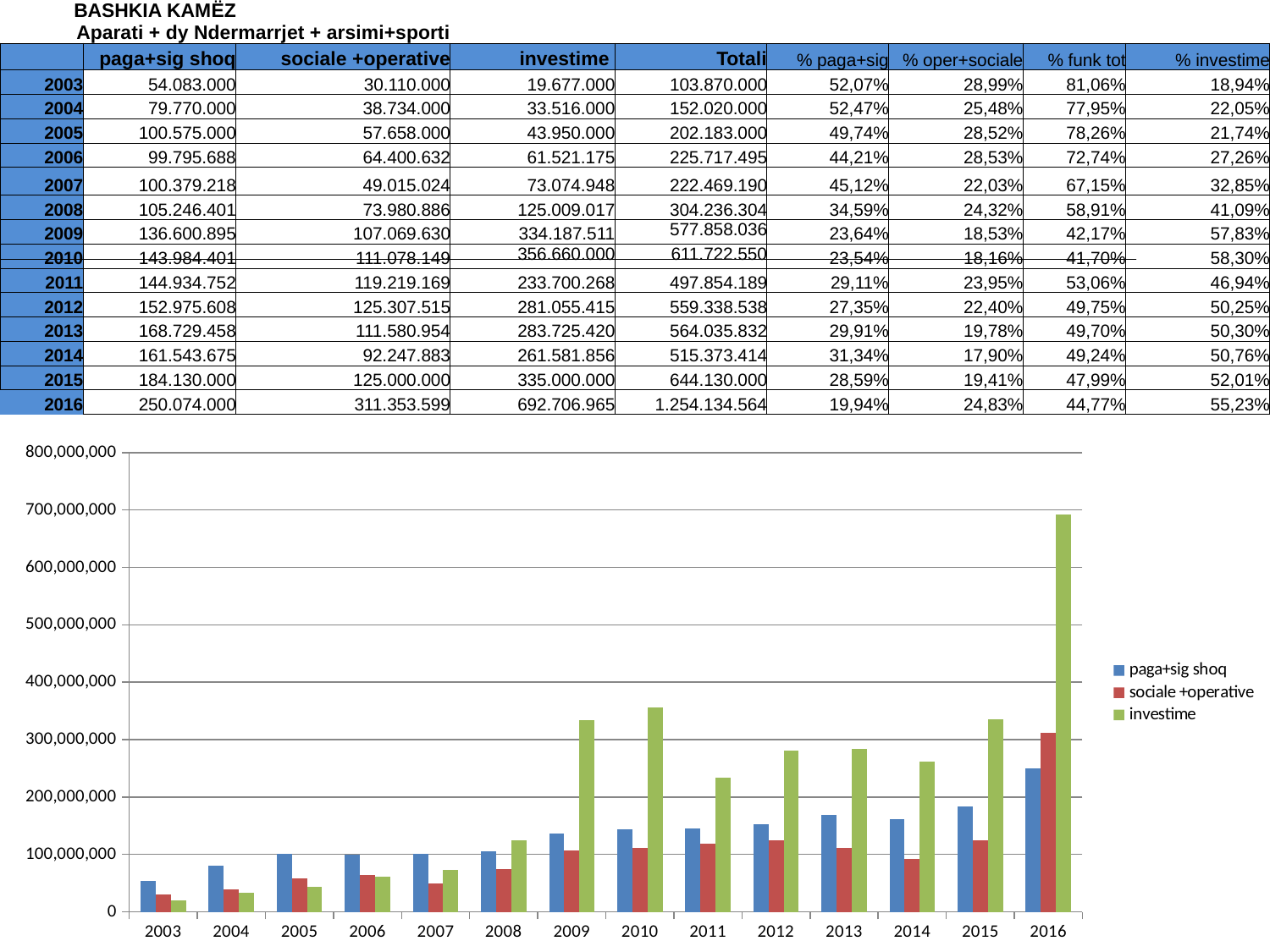
Which colour represents investime in the chart legend? green In 2016, which is larger: investime or sociale +operative? investime Is the investime value for 2016 greater or less than 600,000,000? greater How many years are shown along the x axis of the chart? 14 Is the paga+sig shoq value for 2003 greater or less than 100,000,000? less Does the paga+sig shoq series generally rise or fall from 2003 to 2016? rise In which year is the investime bar the highest? 2016 How many series does the chart legend list? 3 According to the table above the chart, what is the investime value for 2016? 692.706.965 What kind of chart is shown on the slide? bar chart In which year is the investime bar the lowest? 2003 Is the investime value for 2010 greater or less than 300,000,000? greater